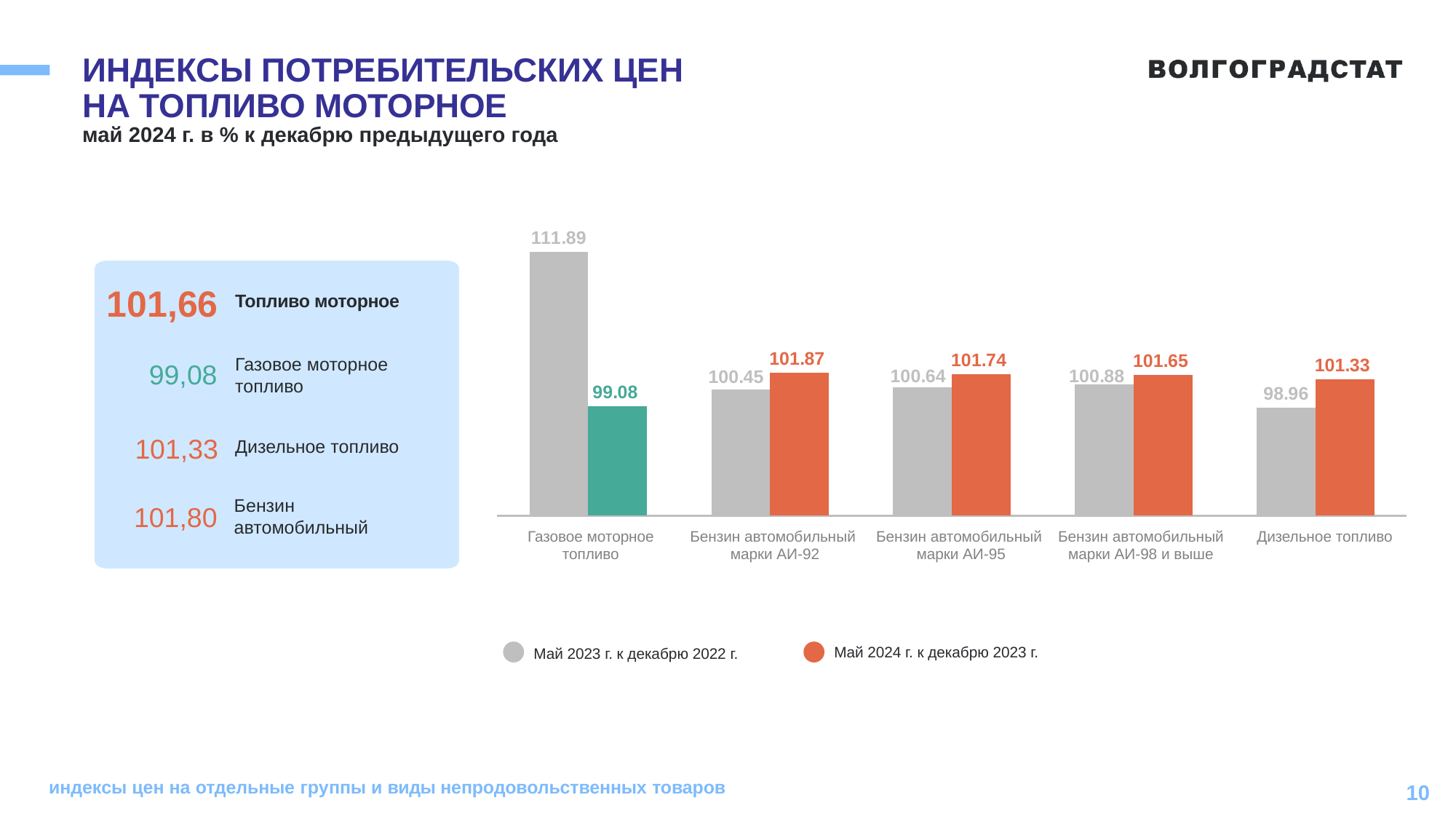
Which category has the lowest value in the series Май 2023 г. к декабрю 2022 г.? Дизельное топливо What is the value for Бензин автомобильный марки АИ-95 in the series Май 2023 г. к декабрю 2022 г.? 100.64 How many series does the chart legend list? 2 How many fuel categories are shown on the x axis of the chart? 5 Which category has the highest value in the series Май 2024 г. к декабрю 2023 г.? Бензин автомобильный марки АИ-92 What is the difference between the two series values for Газовое моторное топливо? 12.81 What is the value for Дизельное топливо in the series Май 2024 г. к декабрю 2023 г.? 101.33 What type of chart is shown on the slide? bar chart What is the value for Газовое моторное топливо in the series Май 2023 г. к декабрю 2022 г.? 111.89 Which colour represents the series Май 2023 г. к декабрю 2022 г. in the chart legend? grey What is the difference between the Май 2024 г. к декабрю 2023 г. values for Бензин автомобильный марки АИ-92 and Бензин автомобильный марки АИ-98 и выше? 0.22 For Дизельное топливо, which series has the larger value: Май 2023 г. к декабрю 2022 г. or Май 2024 г. к декабрю 2023 г.? Май 2024 г. к декабрю 2023 г.